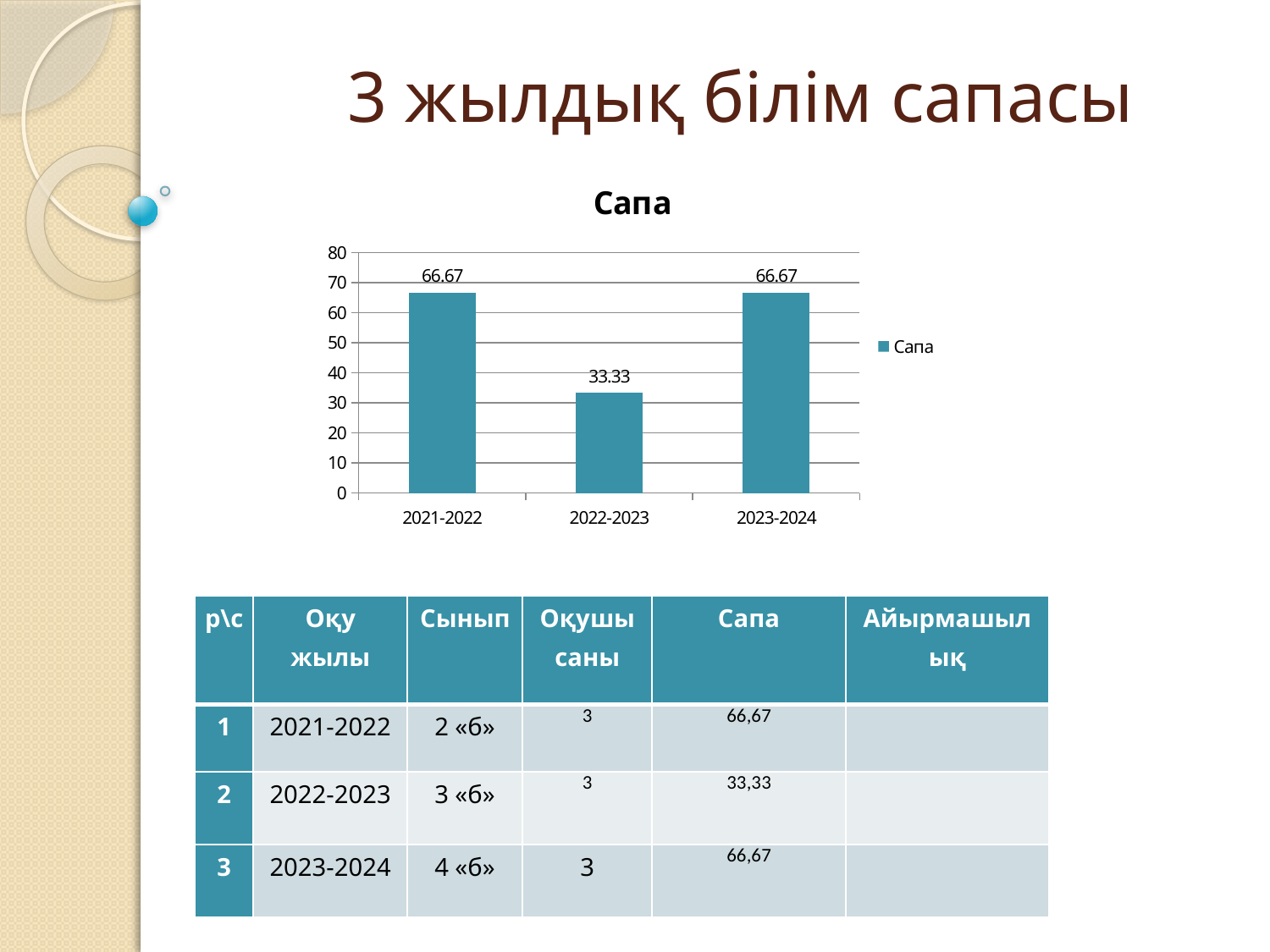
What is the value for 2022-2023 in the chart? 33.33 What is the value for 2023-2024 in the chart? 66.67 How many series does the chart legend list? 1 Is the value for 2021-2022 greater or less than 60? greater What is the difference between the values for 2021-2022 and 2022-2023? 33.34 What is the title of the chart? Сапа How many categories are shown on the x axis of the chart? 3 What kind of chart is shown on the slide? bar chart What is the value for 2021-2022 in the chart? 66.67 Which is larger, the value for 2022-2023 or the value for 2023-2024? 2023-2024 Which category has the lowest value in the chart? 2022-2023 Is the value for 2022-2023 greater or less than 40? less